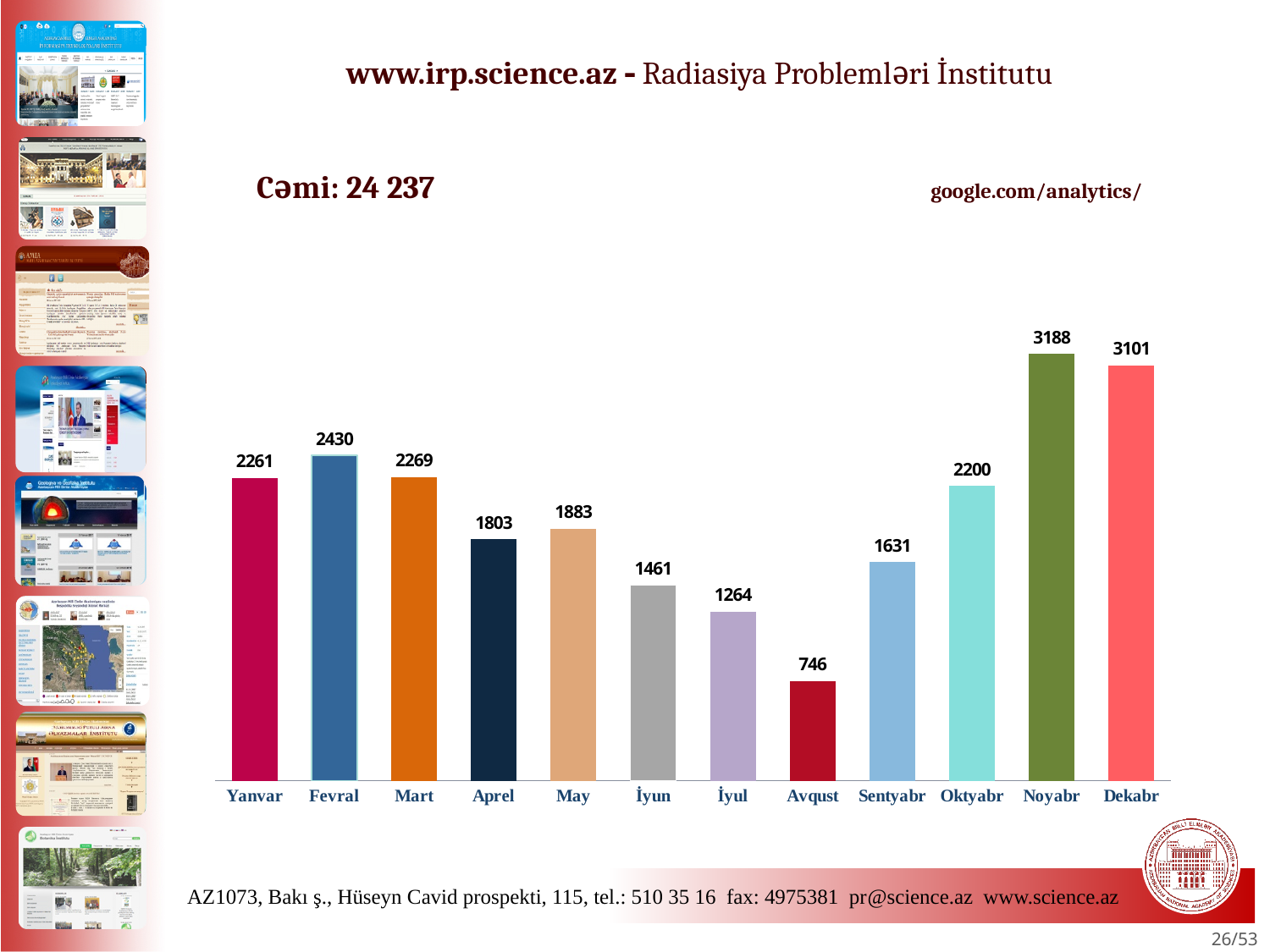
Which is larger, the value for Mart or the value for Aprel? Mart Which is larger, the value for İyun or the value for Sentyabr? Sentyabr Which month has the highest value? Noyabr What kind of chart is shown on the slide? Bar chart What total (Cəmi) is stated above the chart? 24 237 What is the difference between the values for Fevral and Yanvar? 169 What is the value for Noyabr? 3188 How many months are shown in the chart? 12 What is the value for Sentyabr? 1631 What is the value for Avqust? 746 What is the difference between the values for Noyabr and Dekabr? 87 Which month has the lowest value? Avqust